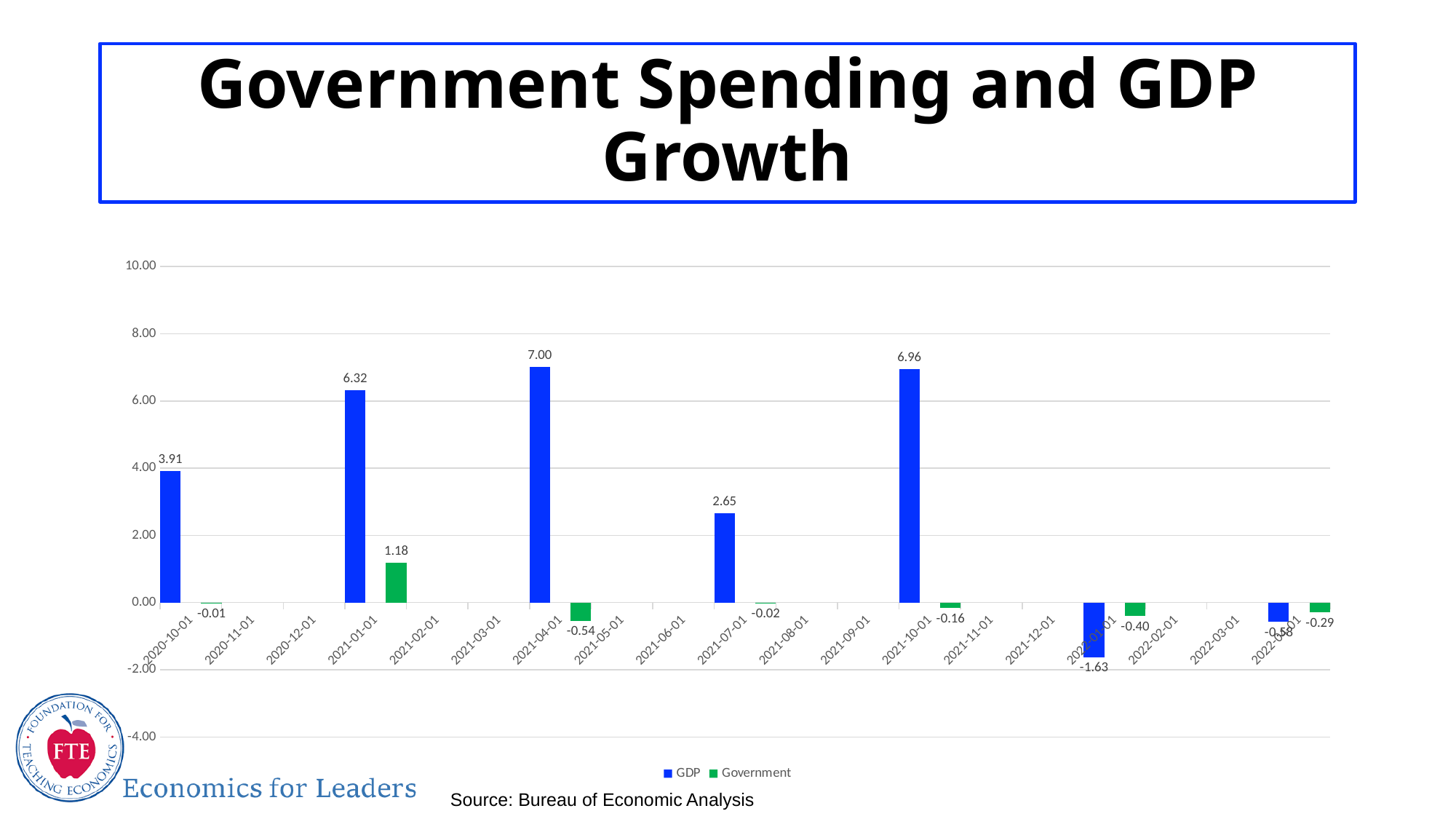
Which date has the highest Government value? 2021-01-01 What kind of chart is shown on the slide? Bar chart Which is larger, the GDP value for 2021-04-01 or the GDP value for 2021-10-01? 2021-04-01 What source is cited for the chart data? Bureau of Economic Analysis What is the GDP value for 2021-07-01? 2.65 What is the Government value for 2021-04-01? -0.54 What is the lowest GDP value shown on the chart? -1.63 What is the GDP value for 2021-04-01? 7.00 How many series does the legend list? 2 What is the difference between the GDP value and the Government value for 2021-01-01? 5.14 Is the GDP value for 2021-01-01 greater or less than 6.00? greater What is the Government value for 2021-01-01? 1.18